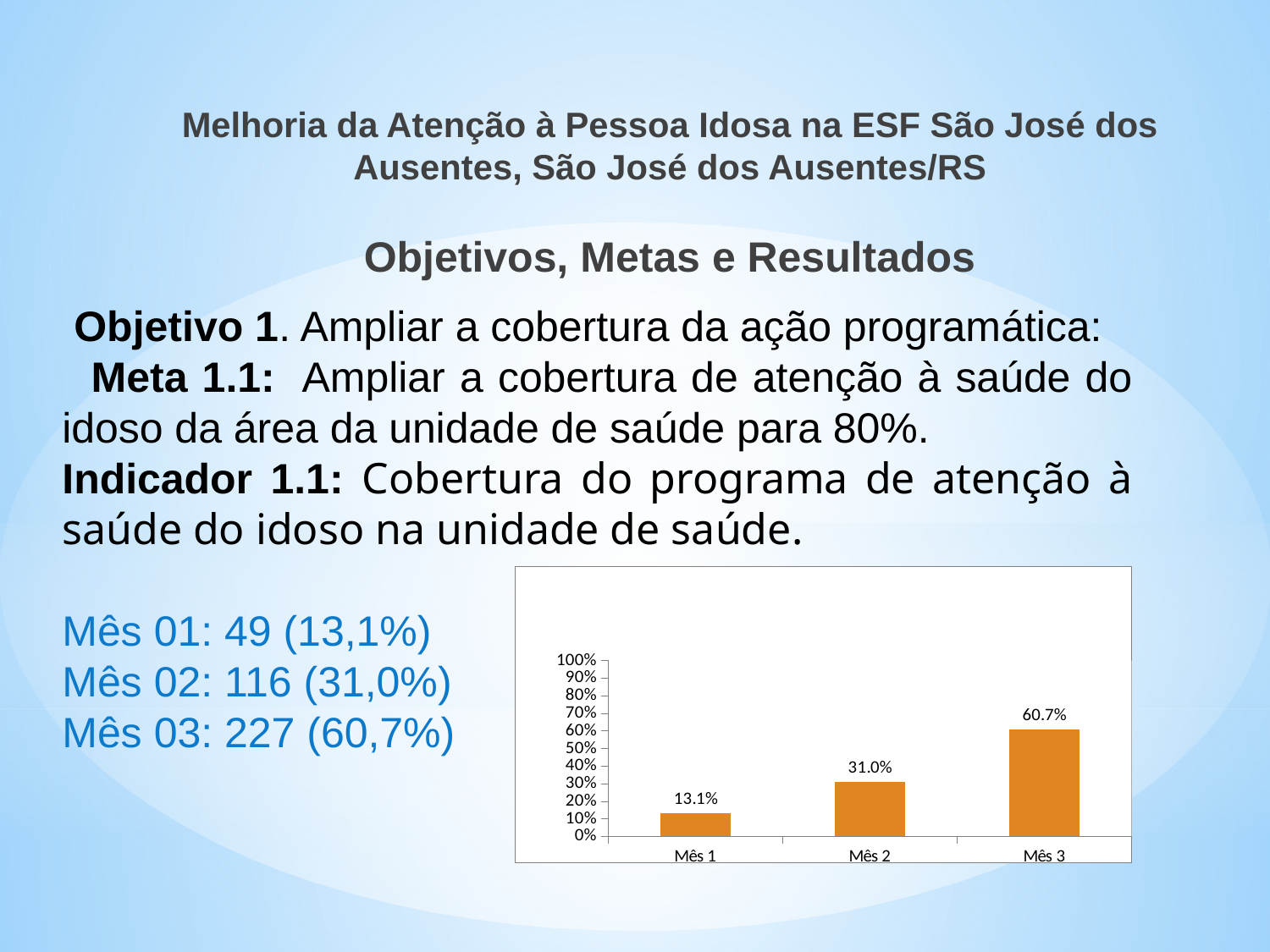
Is the value for Mês 3 greater or less than 50%? greater Do the values rise or fall from Mês 1 to Mês 3? rise What is the difference between the values for Mês 2 and Mês 1? 17.9% Which month has the lowest value? Mês 1 What is the value for Mês 1? 13.1% Which month has the highest value? Mês 3 How many categories are shown on the x axis? 3 Which is larger, the value for Mês 1 or the value for Mês 2? Mês 2 What is the difference between the values for Mês 3 and Mês 2? 29.7% What is the value for Mês 2? 31.0% What kind of chart is shown? bar chart What is the value for Mês 3? 60.7%